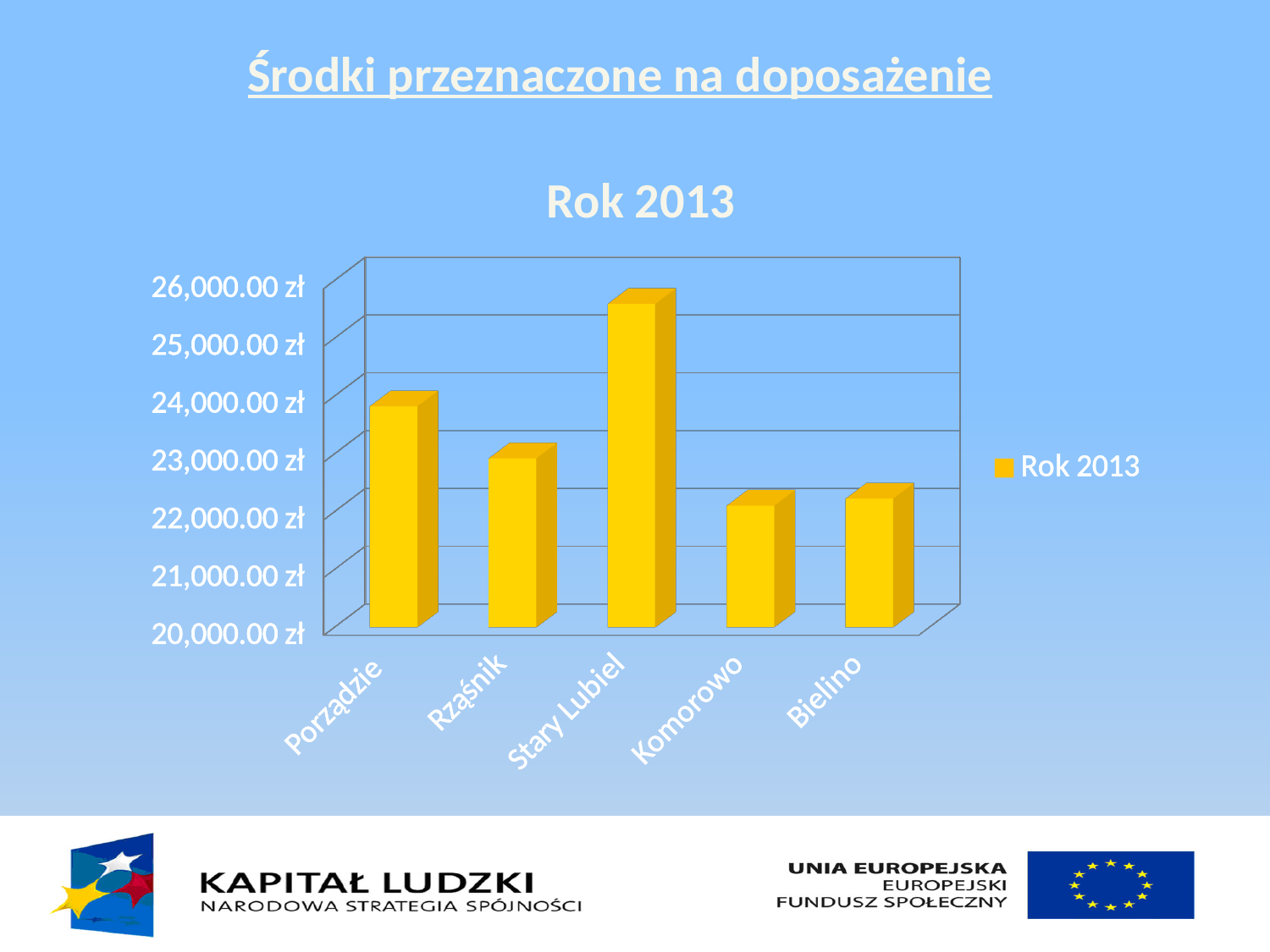
Is the value for Stary Lubiel greater or less than 25,000.00 zł? greater What is the title of the chart? Rok 2013 Which has the larger value, Stary Lubiel or Komorowo? Stary Lubiel Is the value for Rząśnik greater or less than 22,000.00 zł? greater Which category has the highest value in the chart? Stary Lubiel Is the value for Bielino greater or less than 23,000.00 zł? less How many series does the chart's legend list? 1 What kind of chart is shown on the slide? bar chart How many categories are shown on the x axis of the chart? 5 Which has the larger value, Porządzie or Rząśnik? Porządzie